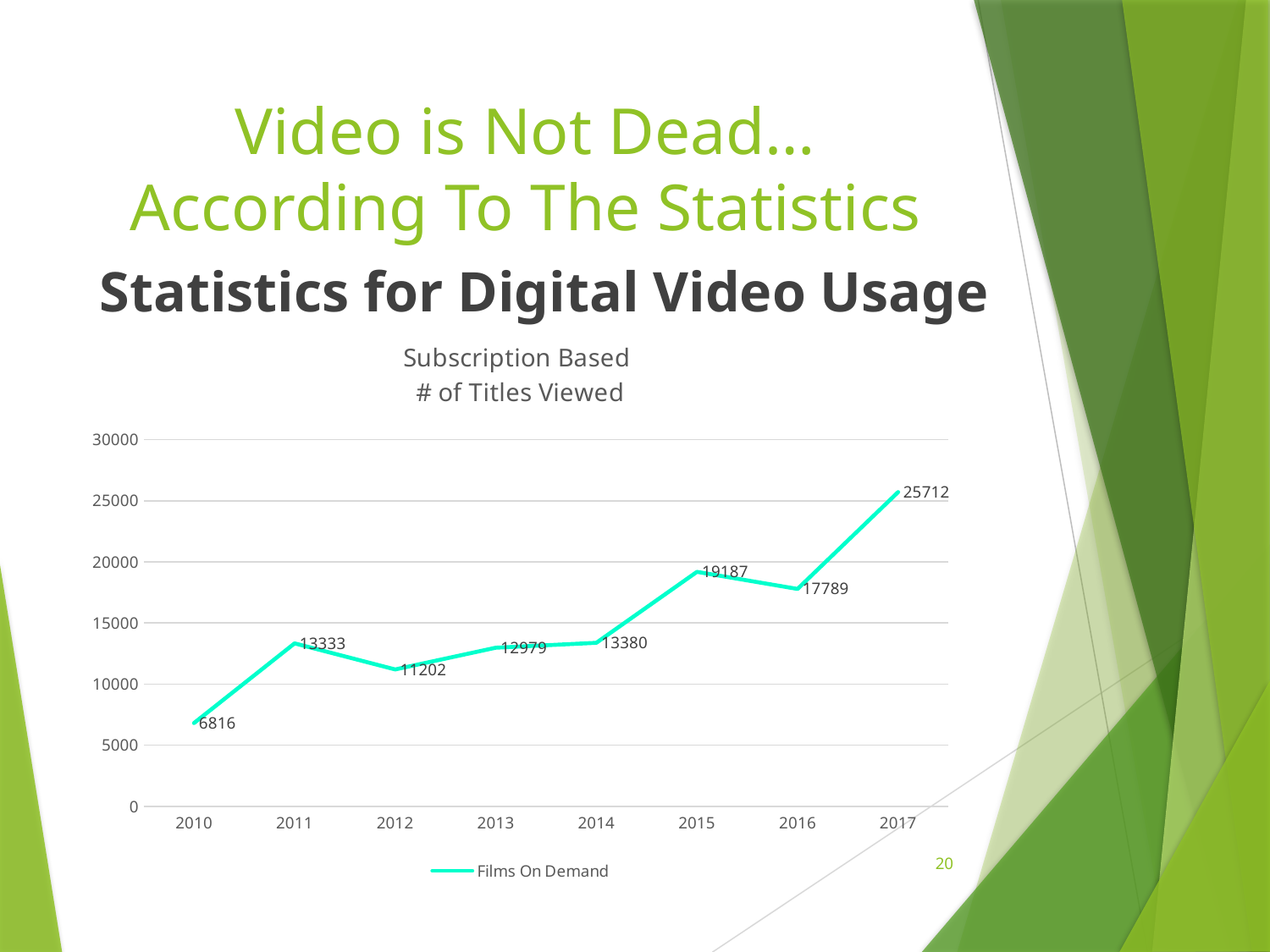
Which year has the highest number of titles viewed? 2017 Which is larger, the value for 2015 or the value for 2016? 2015 Is the value for 2014 greater or less than 15000? less What kind of chart is shown on the slide? line chart How many years are plotted on the x axis? 8 Which year has the lowest number of titles viewed? 2010 What is the value for 2017 in the Subscription Based # of Titles Viewed chart? 25712 What is the value for 2010 in the Subscription Based # of Titles Viewed chart? 6816 What series name does the legend show? Films On Demand What is the difference between the values for 2011 and 2012? 2131 What is the difference between the values for 2017 and 2016? 7923 What is the value for 2013 in the Subscription Based # of Titles Viewed chart? 12979